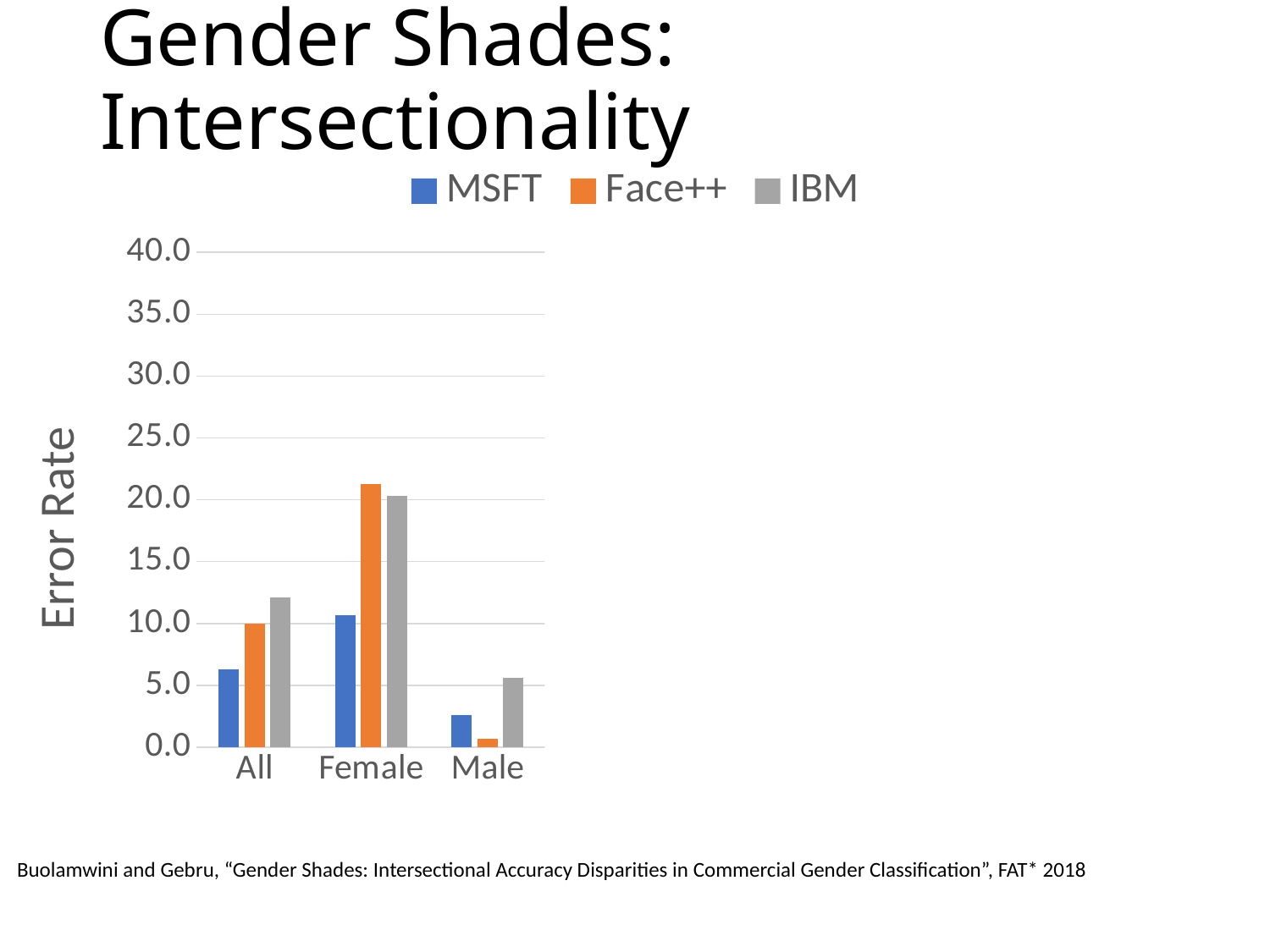
Which series has the lowest error rate for the Male category? Face++ How many categories are shown on the x axis? 3 Is the Face++ error rate for Female greater or less than 20.0? greater Which series has the lowest error rate for the All category? MSFT Which series has the highest error rate for the Male category? IBM Is the IBM error rate for All greater or less than 10.0? greater Which is larger, the MSFT error rate for Female or the MSFT error rate for Male? Female How many series does the legend list? 3 What kind of chart is shown on the slide? bar chart What is the label on the vertical axis of the chart? Error Rate Which series has the highest error rate for the All category? IBM Is the MSFT error rate for Male greater or less than 5.0? less